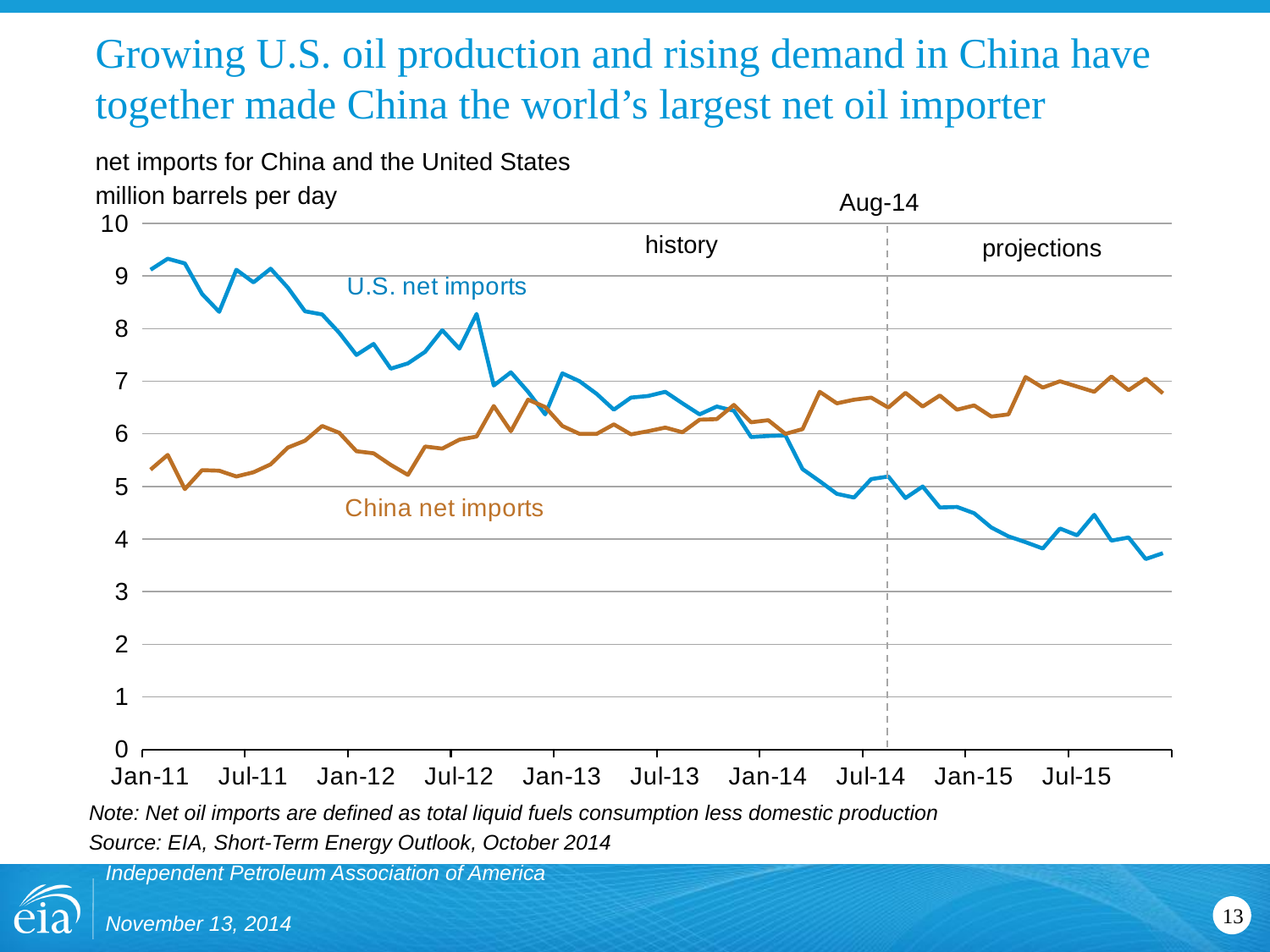
What unit is used on the chart's vertical axis? million barrels per day Do China net imports rise or fall over the period shown on the chart? rise Is the value for U.S. net imports at Jul-15 greater or less than 5? less Is the value for China net imports at Jul-15 greater or less than 6? greater How many series are plotted on the chart? 2 At Jul-15, which series is larger: U.S. net imports or China net imports? China net imports What kind of chart is shown on the slide? line chart At Jan-11, which series is larger: U.S. net imports or China net imports? U.S. net imports Is the value for U.S. net imports at Jan-11 greater or less than 8? greater What date label marks the dashed line separating history from projections? Aug-14 Do U.S. net imports rise or fall over the period shown on the chart? fall